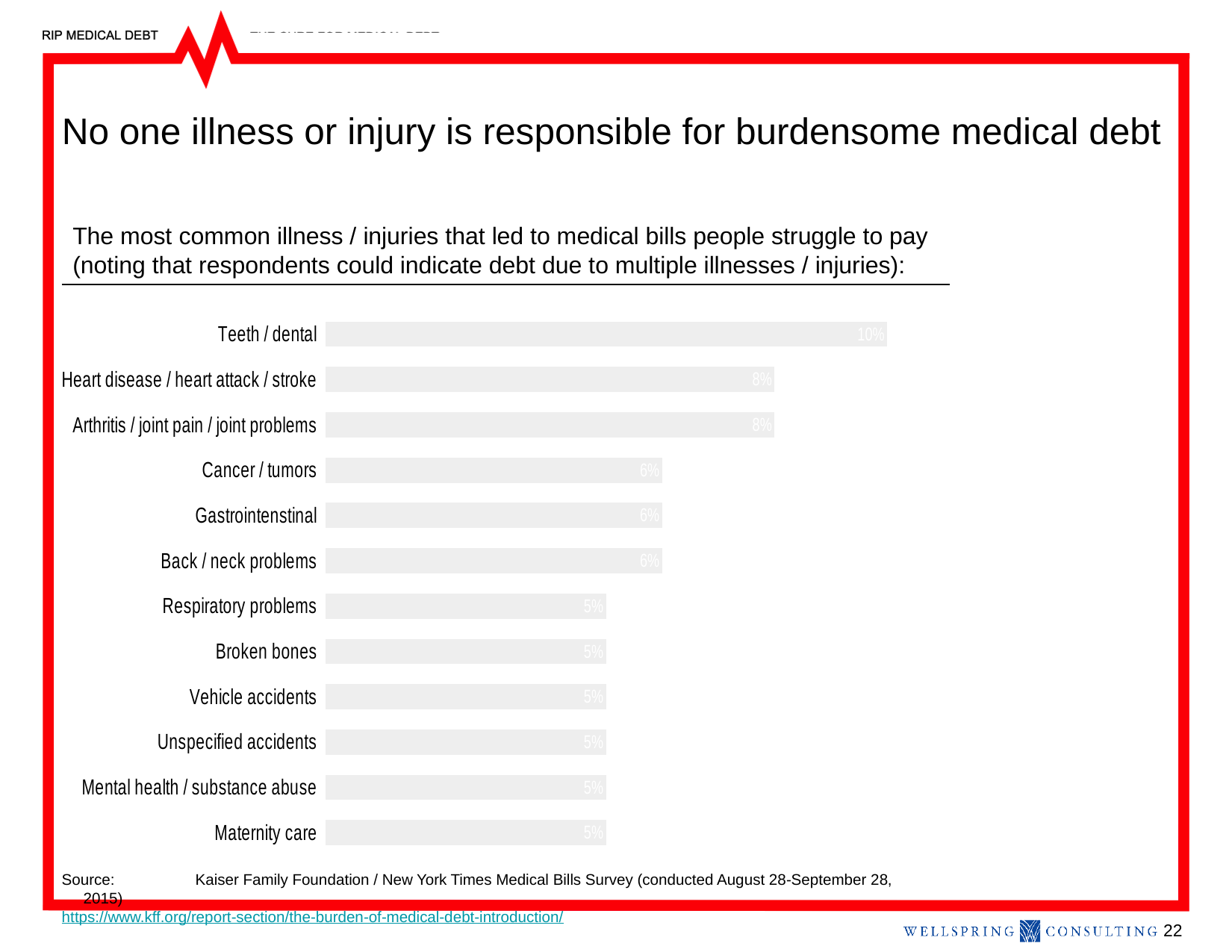
Which is larger, the value for Teeth / dental or the value for Broken bones? Teeth / dental Which is larger, the value for Arthritis / joint pain / joint problems or the value for Back / neck problems? Arthritis / joint pain / joint problems Which illness or injury category has the highest percentage? Teeth / dental How many categories share the lowest value of 5%? 6 What percentage is shown for Cancer / tumors? 6% What percentage is shown for Heart disease / heart attack / stroke? 8% What percentage is shown for Teeth / dental? 10% How many illness / injury categories are shown in the chart? 12 What is the difference in percentage points between Heart disease / heart attack / stroke and Respiratory problems? 3 What percentage is shown for Maternity care? 5% What kind of chart is shown on the slide? Bar chart What is the difference in percentage points between Teeth / dental and Cancer / tumors? 4